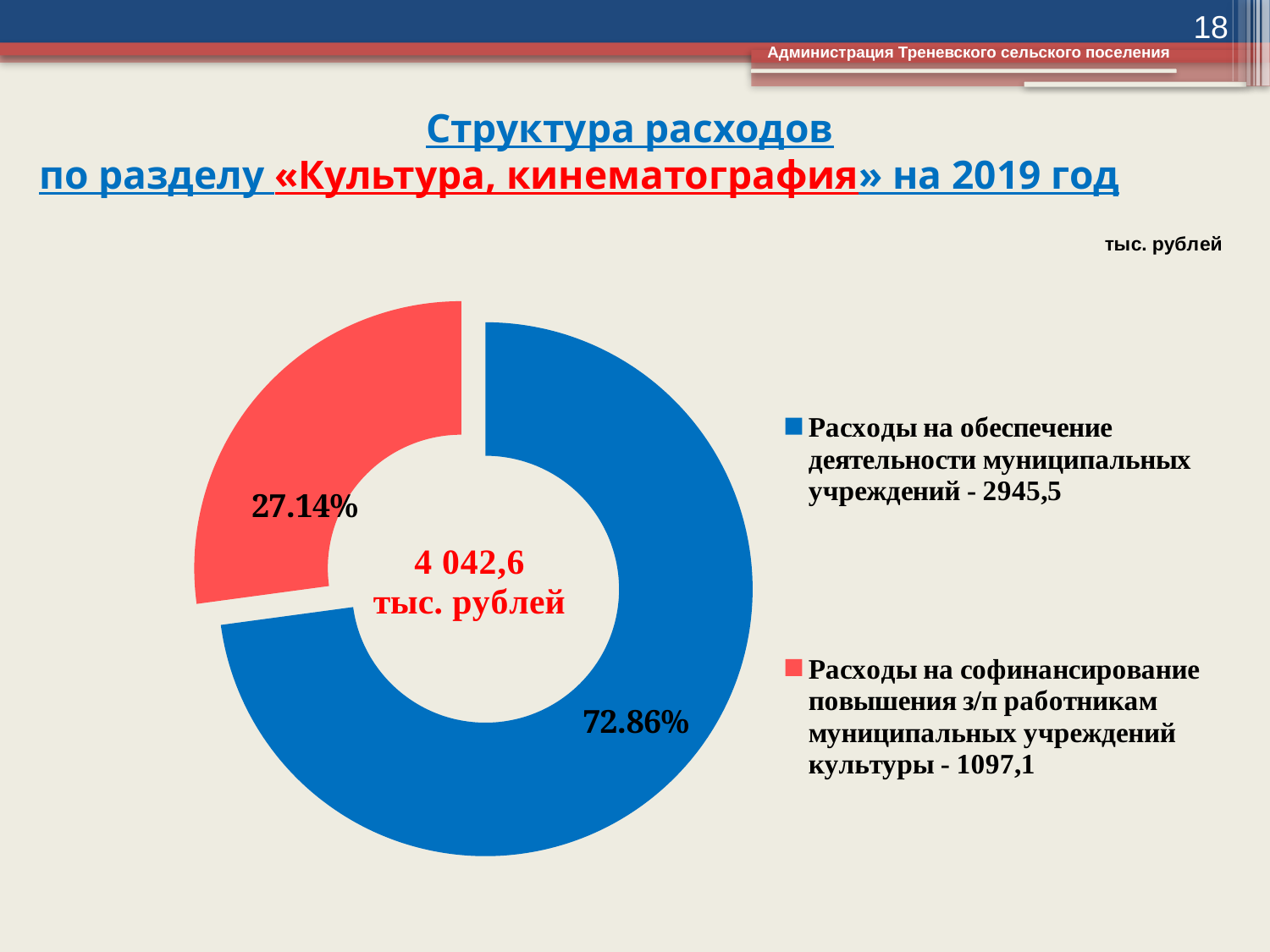
What kind of chart is shown on the slide? Doughnut (pie) chart How many entries does the legend list? 2 What colour is the slice for Расходы на софинансирование повышения з/п работникам муниципальных учреждений культуры? Red What share of the chart is labelled for the red slice (Расходы на софинансирование повышения з/п работникам муниципальных учреждений культуры)? 27.14% What value does the legend give for Расходы на обеспечение деятельности муниципальных учреждений? 2945,5 What total is printed in the centre of the chart? 4 042,6 тыс. рублей How many slices does the chart have? 2 What share of the chart is labelled for the blue slice (Расходы на обеспечение деятельности муниципальных учреждений)? 72.86% Which is larger: the share for Расходы на обеспечение деятельности муниципальных учреждений or the share for Расходы на софинансирование повышения з/п работникам муниципальных учреждений культуры? Расходы на обеспечение деятельности муниципальных учреждений Which category has the smallest share of the chart? Расходы на софинансирование повышения з/п работникам муниципальных учреждений культуры What value does the legend give for Расходы на софинансирование повышения з/п работникам муниципальных учреждений культуры? 1097,1 Which category has the largest share of the chart? Расходы на обеспечение деятельности муниципальных учреждений